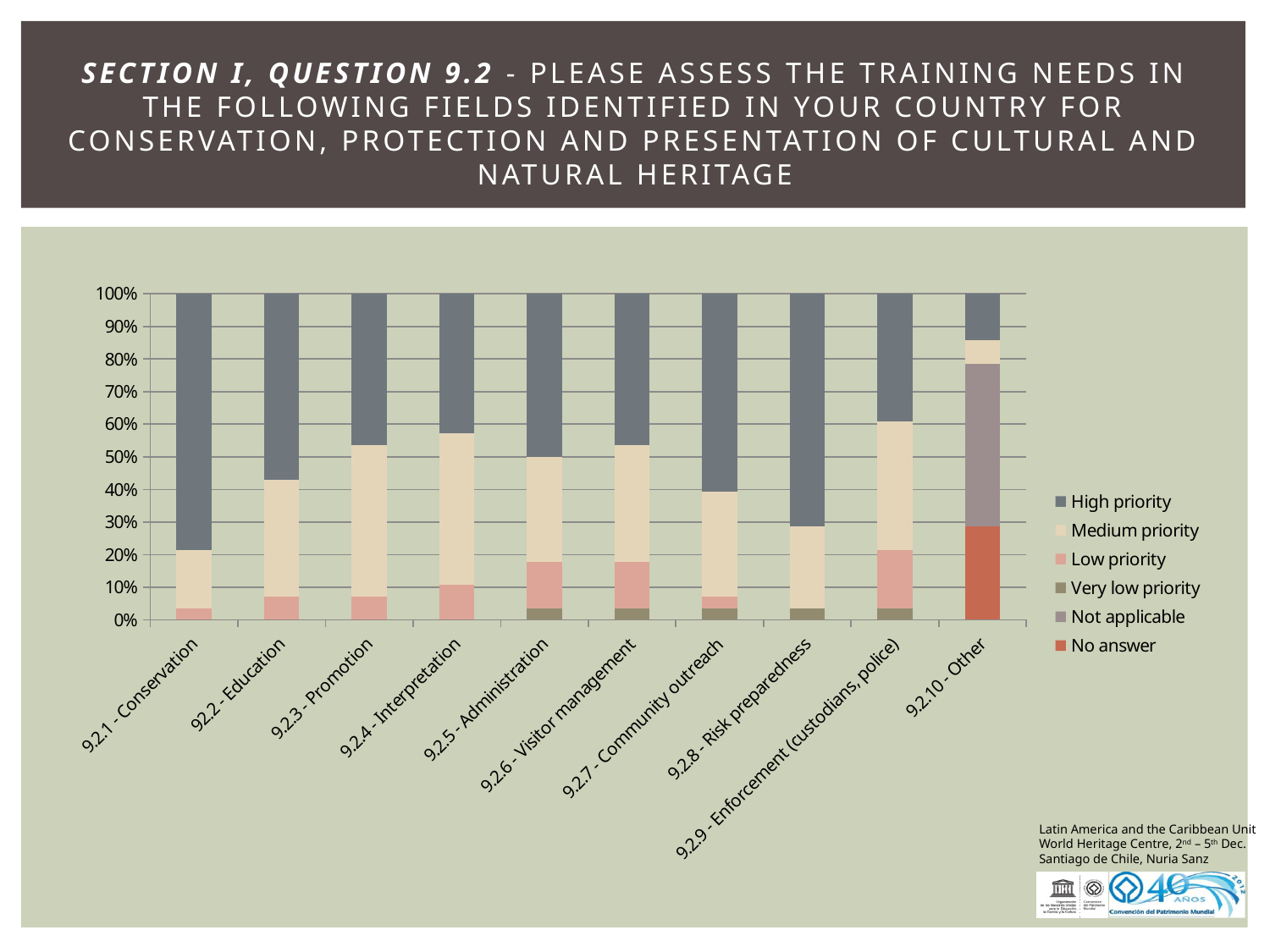
How many categories are shown along the x axis of the chart? 10 Is the High priority share for 9.2.9 - Enforcement (custodians, police) greater or less than 50%? less What is the total of the stacked bar for 9.2.1 - Conservation? 100% Is the High priority share for 9.2.1 - Conservation greater or less than 70%? greater Which category has the largest High priority share? 9.2.1 - Conservation Which legend entry is listed first in the chart's legend? High priority Which category is the only one with a No answer segment? 9.2.10 - Other Which has the larger High priority share: 9.2.1 - Conservation or 9.2.9 - Enforcement (custodians, police)? 9.2.1 - Conservation Which category has the smallest High priority share? 9.2.10 - Other What kind of chart is shown on the slide? Stacked bar chart How many series does the chart's legend list? 6 Is the No answer share for 9.2.10 - Other greater or less than 20%? greater